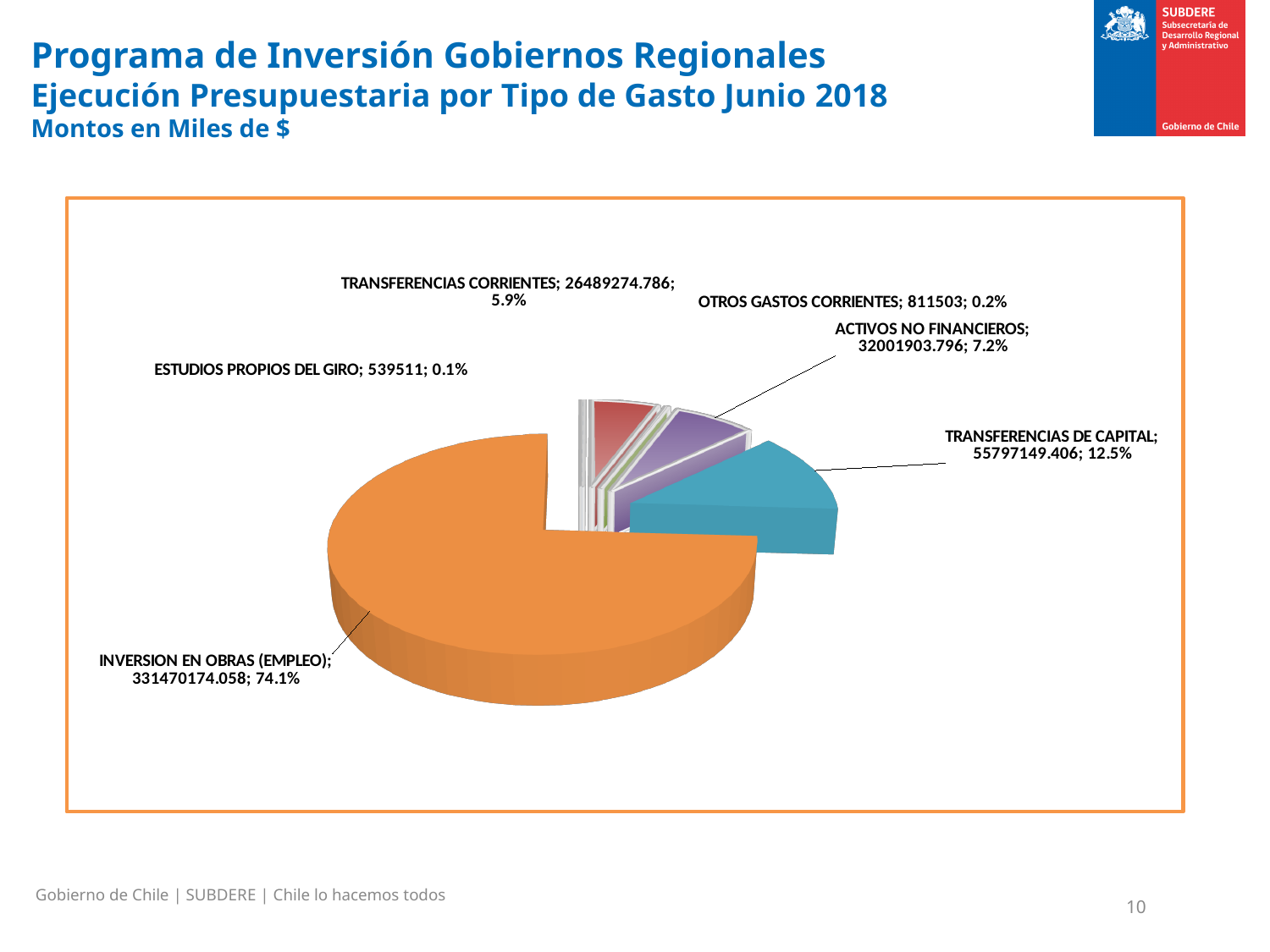
How many categories (slices) does the pie chart show? 6 What is the value shown for TRANSFERENCIAS DE CAPITAL? 55797149.406 Which category has the largest share of the pie chart? INVERSION EN OBRAS (EMPLEO) Which is larger, the value for TRANSFERENCIAS DE CAPITAL or the value for ACTIVOS NO FINANCIEROS? TRANSFERENCIAS DE CAPITAL What percentage share does ACTIVOS NO FINANCIEROS have in the pie chart? 7.2% What is the difference in percentage share between TRANSFERENCIAS DE CAPITAL and ACTIVOS NO FINANCIEROS? 5.3% What kind of chart is shown on the slide? Pie chart What is the difference between the values for OTROS GASTOS CORRIENTES and ESTUDIOS PROPIOS DEL GIRO? 271992 What percentage share does TRANSFERENCIAS CORRIENTES have in the pie chart? 5.9% What is the value shown for INVERSION EN OBRAS (EMPLEO)? 331470174.058 Which category has the smallest share of the pie chart? ESTUDIOS PROPIOS DEL GIRO What is the value shown for OTROS GASTOS CORRIENTES? 811503